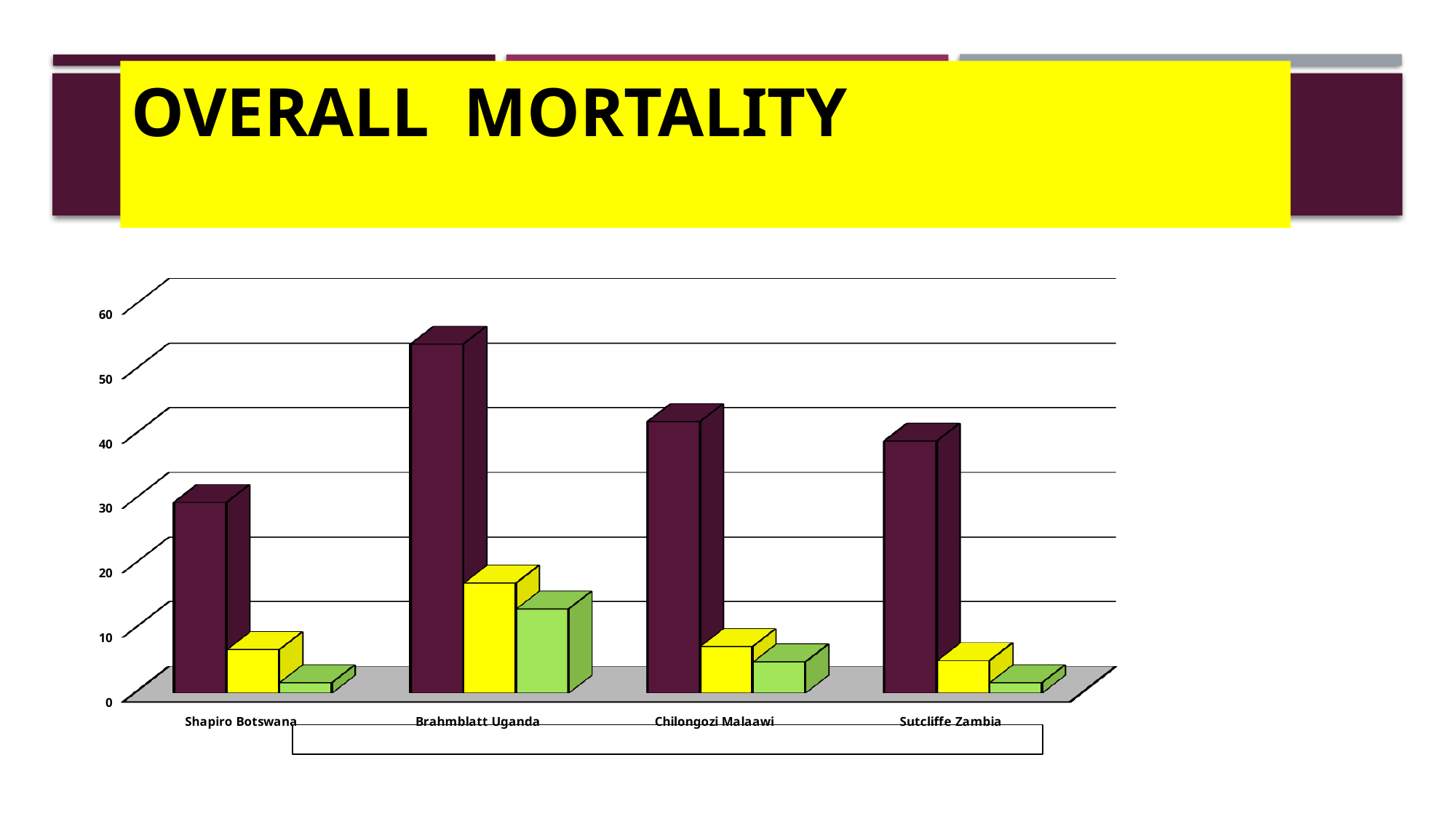
Which has the taller dark purple bar, Shapiro Botswana or Chilongozi Malaawi? Chilongozi Malaawi Is the dark purple bar for Brahmblatt Uganda greater or less than 50? greater What kind of chart is shown on the slide? Bar chart What is the title of the slide? OVERALL MORTALITY Which category has the tallest dark purple bar? Brahmblatt Uganda Which category has the shortest dark purple bar? Shapiro Botswana Is the dark purple bar for Sutcliffe Zambia greater or less than 50? less How many categories are shown along the x axis of the chart? 4 How many bars are plotted for each category in the chart? 3 Which category has the tallest green bar? Brahmblatt Uganda Is the dark purple bar for Shapiro Botswana greater or less than 40? less Which category has the tallest yellow bar? Brahmblatt Uganda